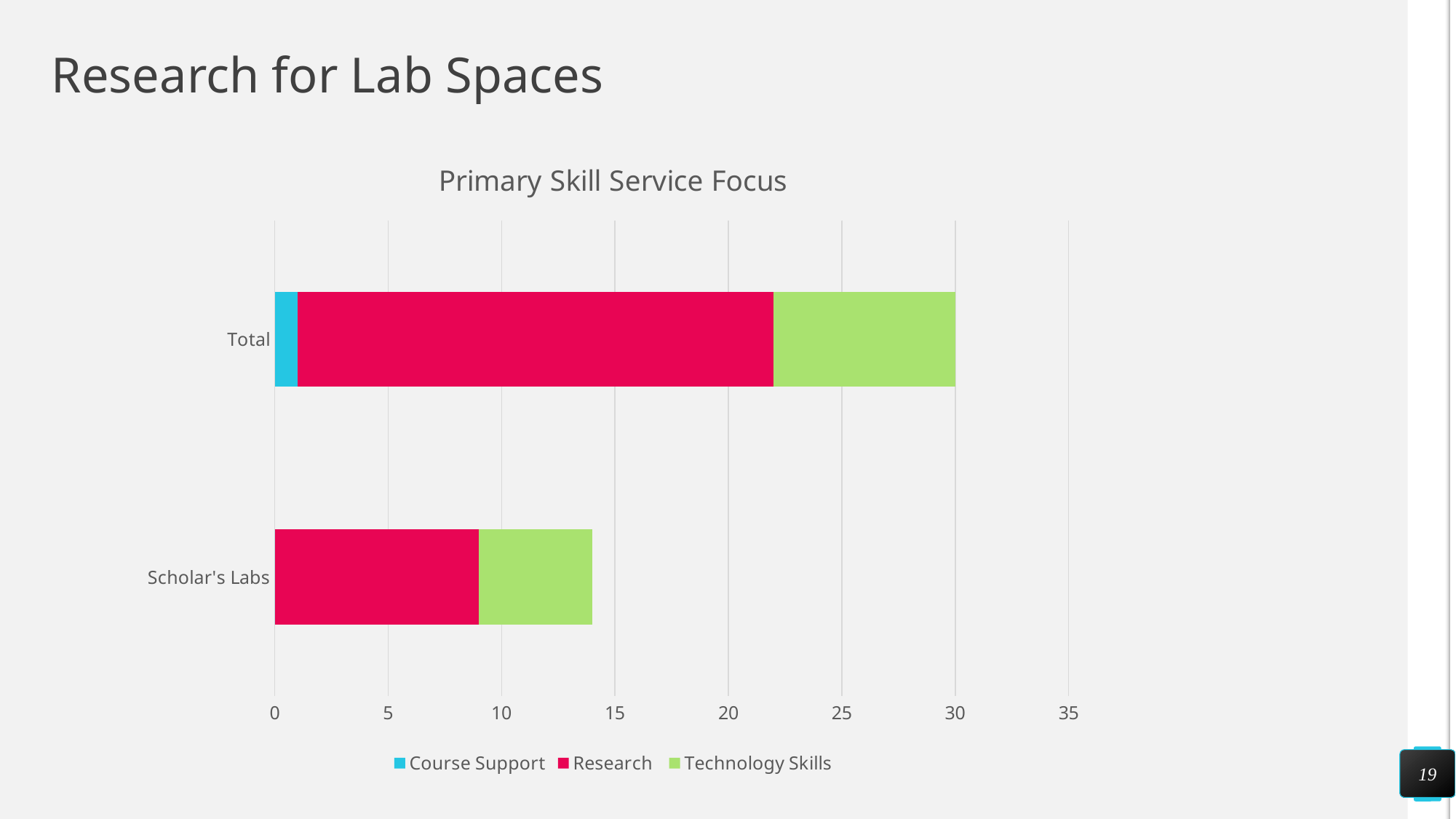
Is the Research value for Scholar's Labs greater or less than 10? less Is the Research value for Total greater or less than 20? greater For Total, which is larger: Research or Technology Skills? Research What kind of chart is shown on the slide? Stacked bar chart What is the title of the chart? Primary Skill Service Focus How many series does the legend list? 3 Is the total of the stacked bar for Scholar's Labs greater or less than 15? less How many categories are plotted on the chart? 2 What is the total of the stacked bar for Total? 30 Which series are listed in the legend? Course Support, Research, Technology Skills Which category has the longer stacked bar? Total